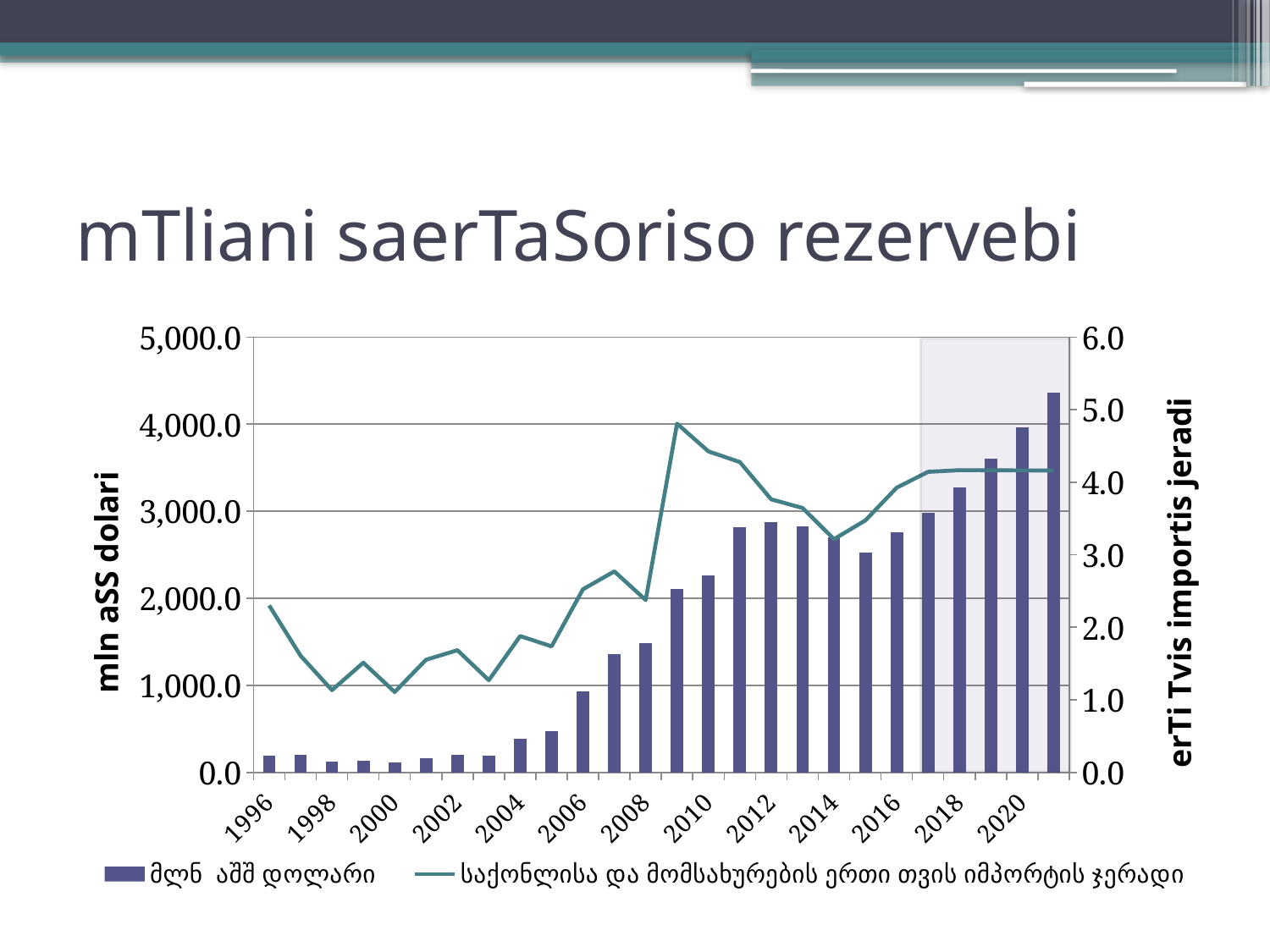
Which bar is taller, 2008 or 2012? 2012 What kind of chart is shown on the slide? A combined bar and line chart Is the bar value for 2006 greater or less than 1,000.0? less What is the title of the slide? mTliani saerTaSoriso rezervebi What is the label of the left vertical axis? mln aSS dolari How many series does the legend list? 2 Is the line value for 2000 greater or less than 2.0? less Is the bar value for 2018 greater or less than 3,000.0? greater Do the bar values rise or fall from 2016 to 2020? rise In which year does the line series reach its highest value? 2009